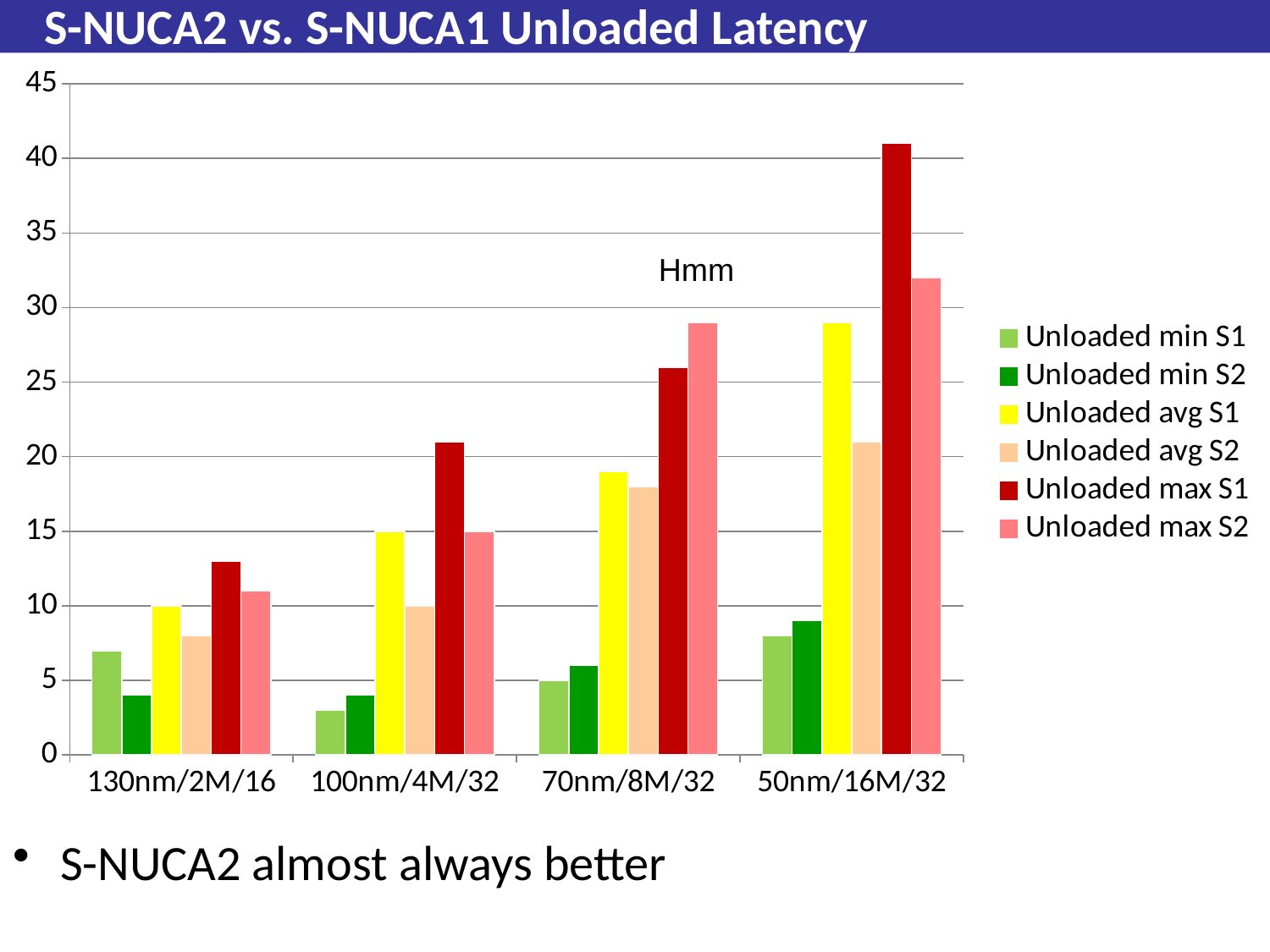
Do the Unloaded max S1 values rise or fall from 130nm/2M/16 to 50nm/16M/32? rise Is the Unloaded max S2 value for 50nm/16M/32 greater or less than 30? greater What is the title of the chart? S-NUCA2 vs. S-NUCA1 Unloaded Latency Which category has the highest Unloaded max S1 value? 50nm/16M/32 How many categories are shown on the x axis? 4 For 70nm/8M/32, which is larger: Unloaded max S1 or Unloaded max S2? Unloaded max S2 Which category has the lowest Unloaded min S1 value? 100nm/4M/32 How many series does the legend list? 6 Is the Unloaded max S1 value for 50nm/16M/32 greater or less than 40? greater Is the Unloaded avg S2 value for 70nm/8M/32 greater or less than 15? greater For 130nm/2M/16, which is larger: Unloaded min S1 or Unloaded min S2? Unloaded min S1 What kind of chart is shown on the slide? bar chart